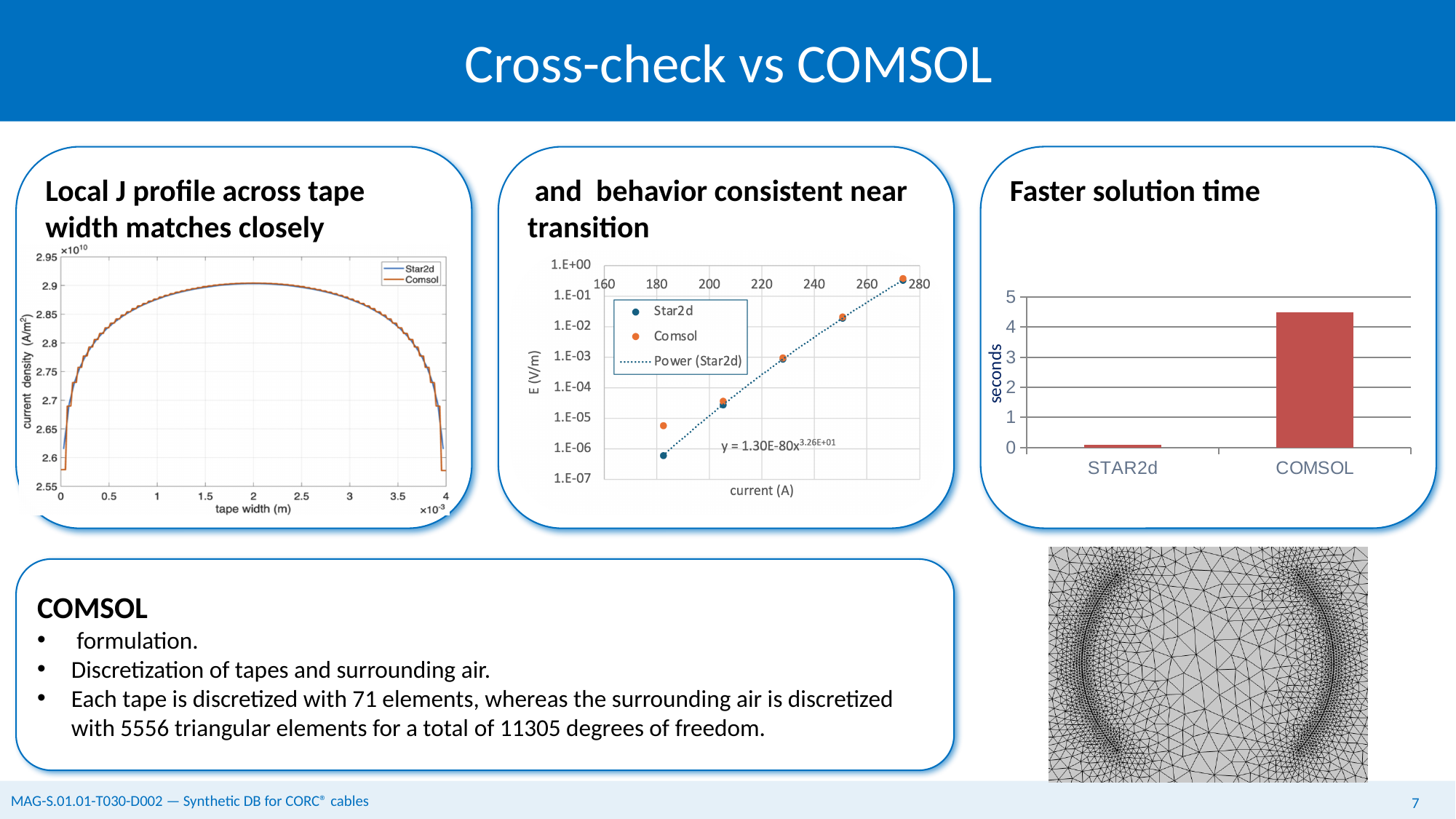
In the 'Faster solution time' bar chart, which category has the highest value? COMSOL In the 'Faster solution time' bar chart, which is larger, STAR2d or COMSOL? COMSOL In the 'Faster solution time' bar chart, is the value for STAR2d greater or less than 1? less How many series does the legend list in the middle chart (E vs current)? 3 In the 'Faster solution time' bar chart, is the value for COMSOL greater or less than 4? greater How many categories are shown in the 'Faster solution time' bar chart? 2 How many series does the legend list in the left chart (current density vs tape width)? 2 What kind of chart is the 'Faster solution time' chart on the right? bar chart What is the y-axis label of the 'Faster solution time' bar chart? seconds In the 'Faster solution time' bar chart, which category has the lowest value? STAR2d In the middle chart (E vs current), do the values rise or fall as current increases? rise What is the x-axis label of the middle chart (E vs current)? current (A)